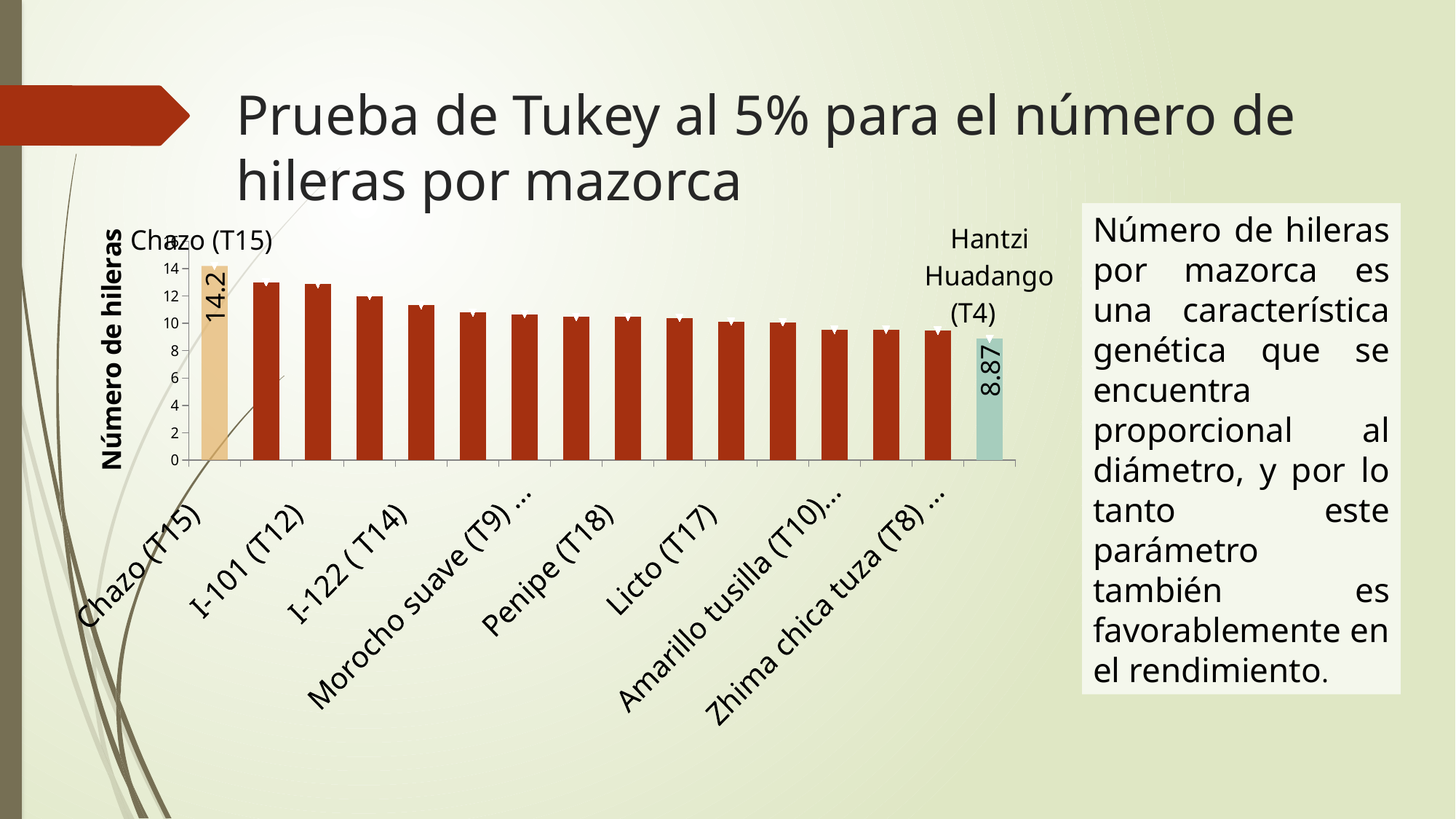
Which variety has the lowest number of rows per ear? Hantzi Huadango (T4) Is the value for Zhima chica tuza (T8) greater or less than 10? less Is the value for I-101 (T12) greater or less than 12? greater Which is larger, the value for Chazo (T15) or the value for Hantzi Huadango (T4)? Chazo (T15) What is the difference between the values for Chazo (T15) and Hantzi Huadango (T4)? 5.33 What is the value for Hantzi Huadango (T4)? 8.87 Do the values rise or fall from left to right along the x axis? fall Is the value for Penipe (T18) greater or less than 12? less How many bars are plotted in the chart? 16 What kind of chart is shown on the slide? bar chart What is the value for Chazo (T15)? 14.2 Which variety has the highest number of rows per ear? Chazo (T15)